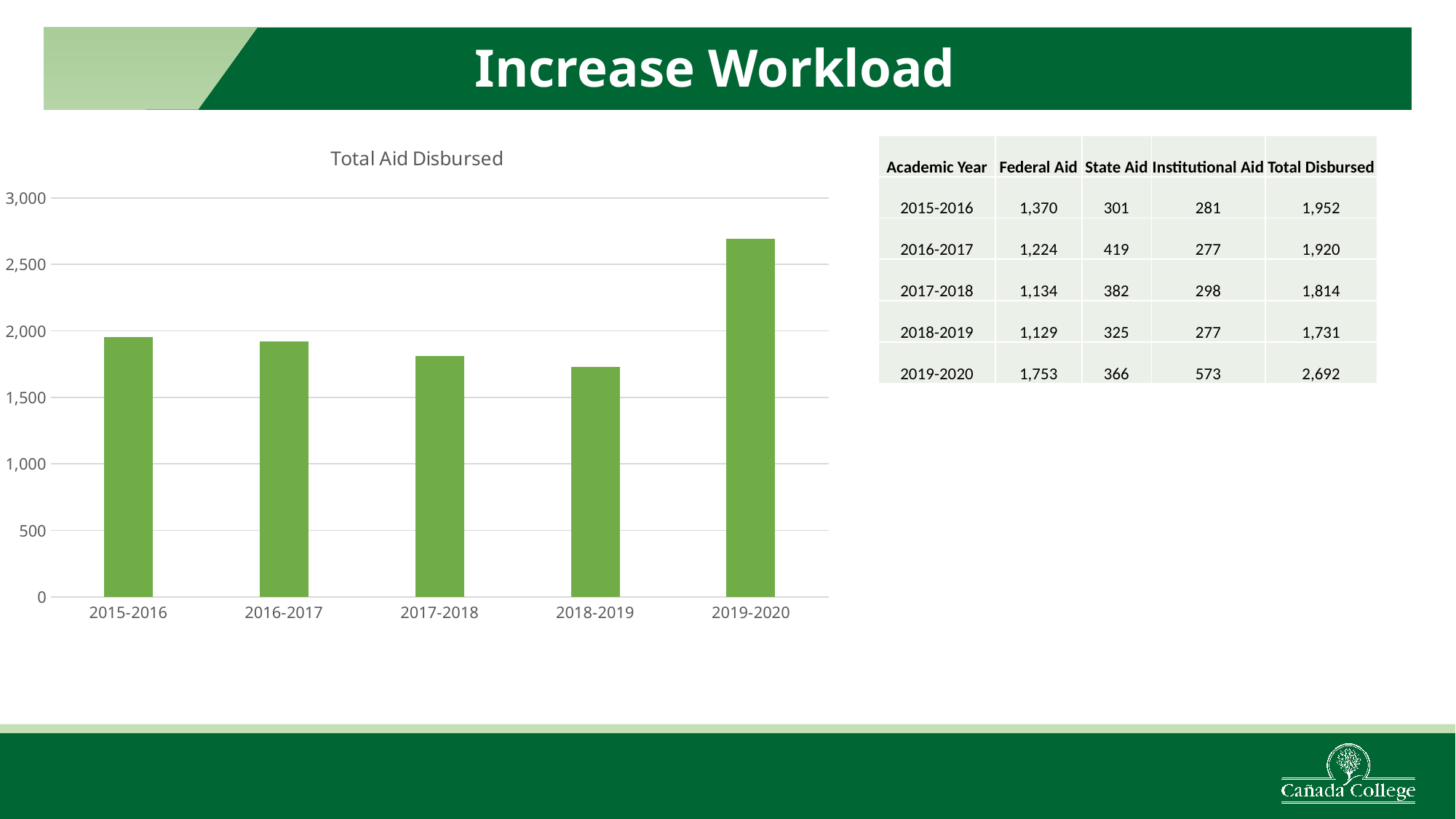
Is the value for 2018-2019 greater or less than 2,000? less What is the total aid disbursed for 2019-2020, as shown in the table next to the chart? 2,692 How does total aid disbursed change from 2015-2016 through 2018-2019 in the chart? It falls each year What is the title of the chart? Total Aid Disbursed Which is larger, the total aid disbursed for 2017-2018 or for 2019-2020? 2019-2020 Which academic year has the highest total aid disbursed in the chart? 2019-2020 What type of chart is shown on the slide? bar chart What is the difference between the total disbursed for 2019-2020 and 2018-2019, using the values in the table? 961 Which academic year has the lowest total aid disbursed in the chart? 2018-2019 Is the value for 2017-2018 greater or less than 1,500? greater Is the value for 2019-2020 greater or less than 2,500? greater How many academic years are plotted in the chart? 5